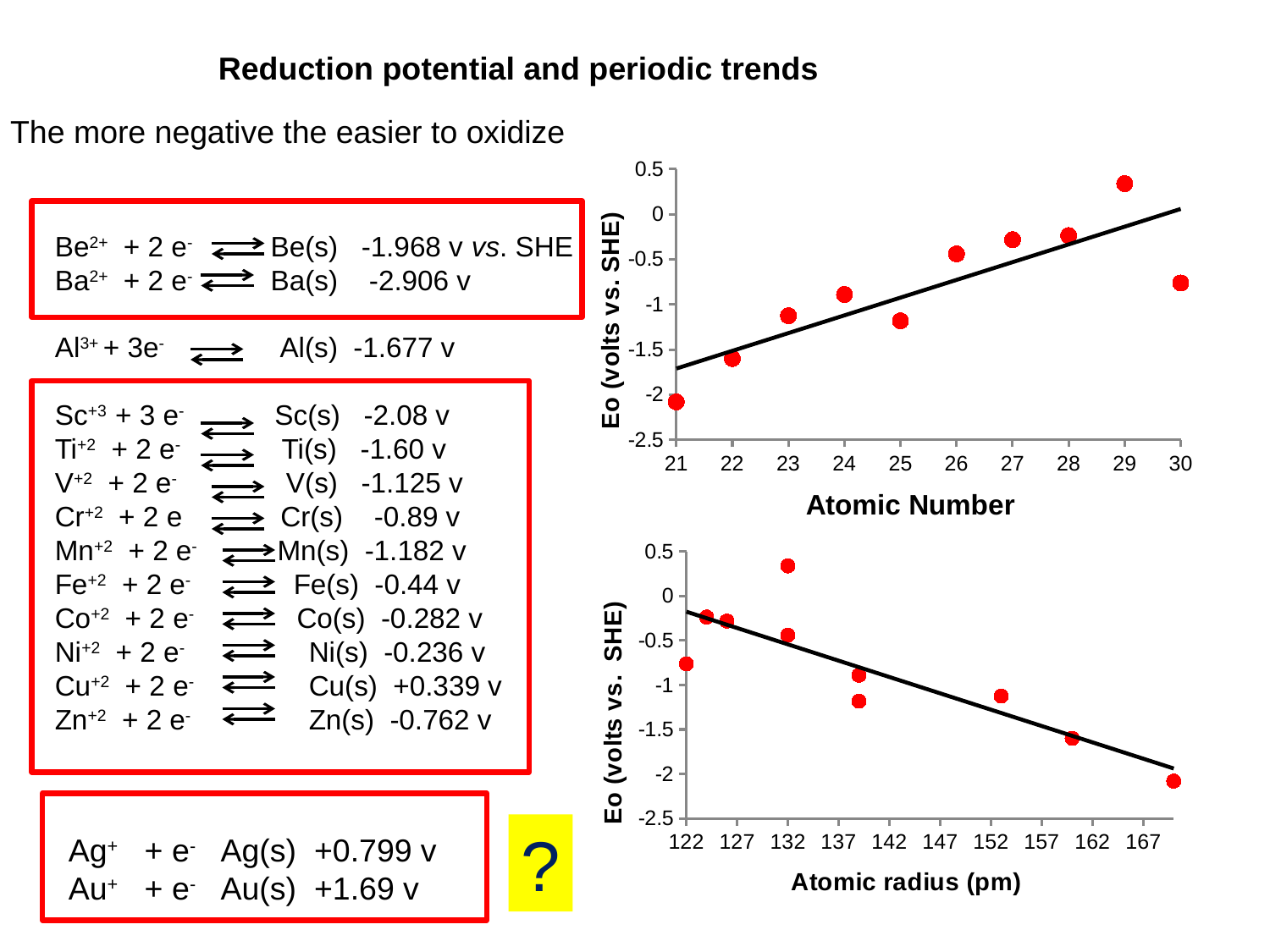
What is the y-axis title of the bottom chart (Atomic radius)? Eo (volts vs. SHE) In the bottom chart (Atomic radius), is the value at atomic radius 122 pm greater or less than -0.5? less In the top chart (Atomic Number), which has the larger Eo value, atomic number 29 or atomic number 30? 29 What kind of chart is the top chart with x axis 'Atomic Number'? scatter chart In the top chart (Atomic Number), is the value at atomic number 30 greater or less than -0.5? less In the top chart (Atomic Number), at which atomic number is the plotted Eo value highest? 29 In the top chart (Atomic Number), at which atomic number is the plotted Eo value lowest? 21 In the top chart (Atomic Number), do the values generally rise or fall as atomic number increases? rise In the bottom chart (Atomic radius), how many data points are plotted? 10 In the top chart (Atomic Number), how many data points are plotted? 10 In the bottom chart (Atomic radius), do the values generally rise or fall as atomic radius increases? fall In the top chart (Atomic Number), is the value at atomic number 26 greater or less than -1? greater